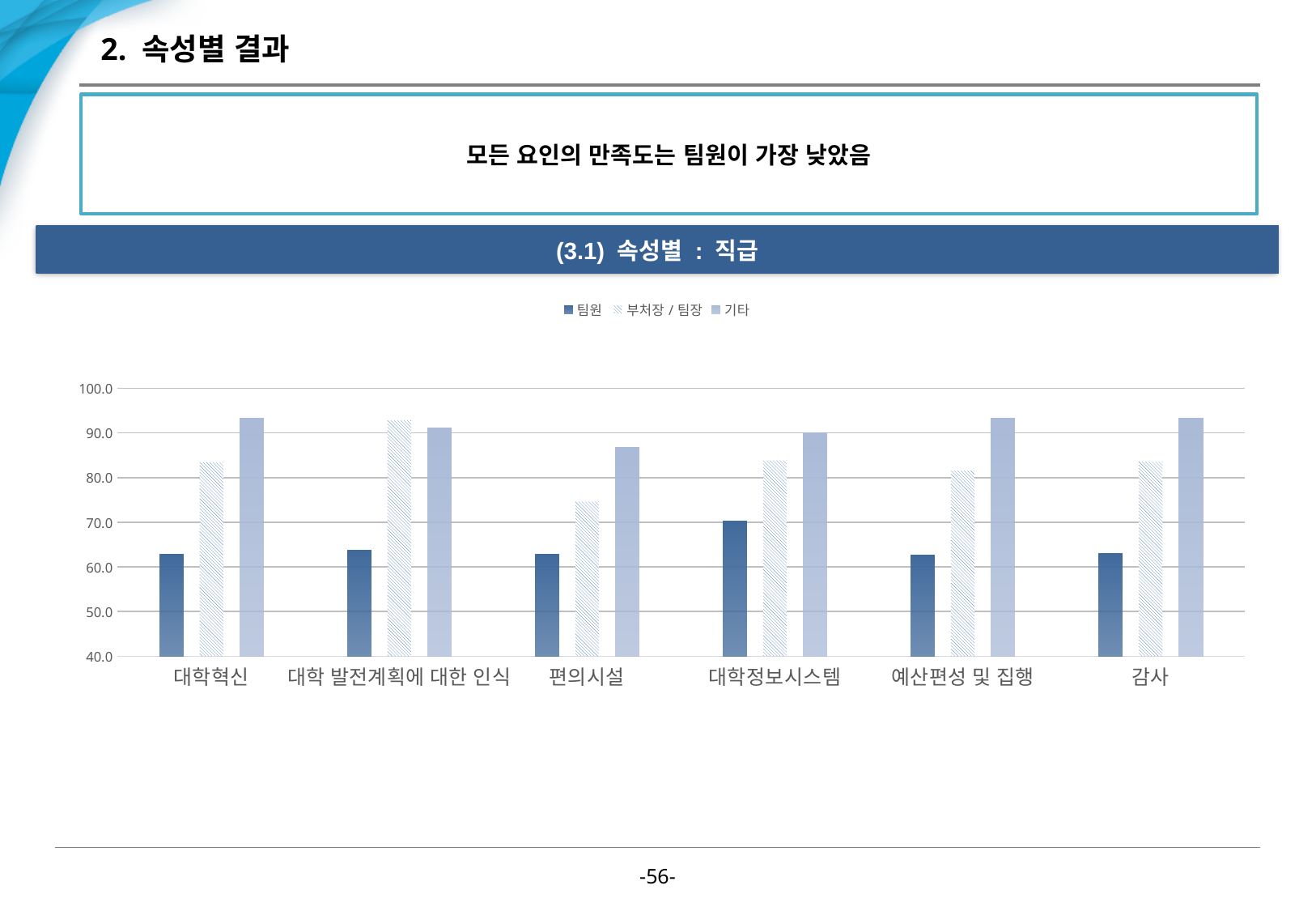
In 편의시설, which is larger: the value for 부처장 / 팀장 or the value for 기타? 기타 Which is larger: the 팀원 value for 대학정보시스템 or the 팀원 value for 편의시설? 대학정보시스템 Among the 부처장 / 팀장 series, which category has the lowest value? 편의시설 Is the value for 부처장 / 팀장 in 편의시설 greater or less than 80? less What kind of chart is shown on the slide? bar chart How many series does the legend list? 3 Among the 팀원 series, which category has the highest value? 대학정보시스템 Is the value for 기타 in 대학혁신 greater or less than 90? greater What are the three series listed in the legend? 팀원, 부처장 / 팀장, 기타 How many categories are shown on the x axis? 6 Is the value for 팀원 in 대학혁신 greater or less than 70? less